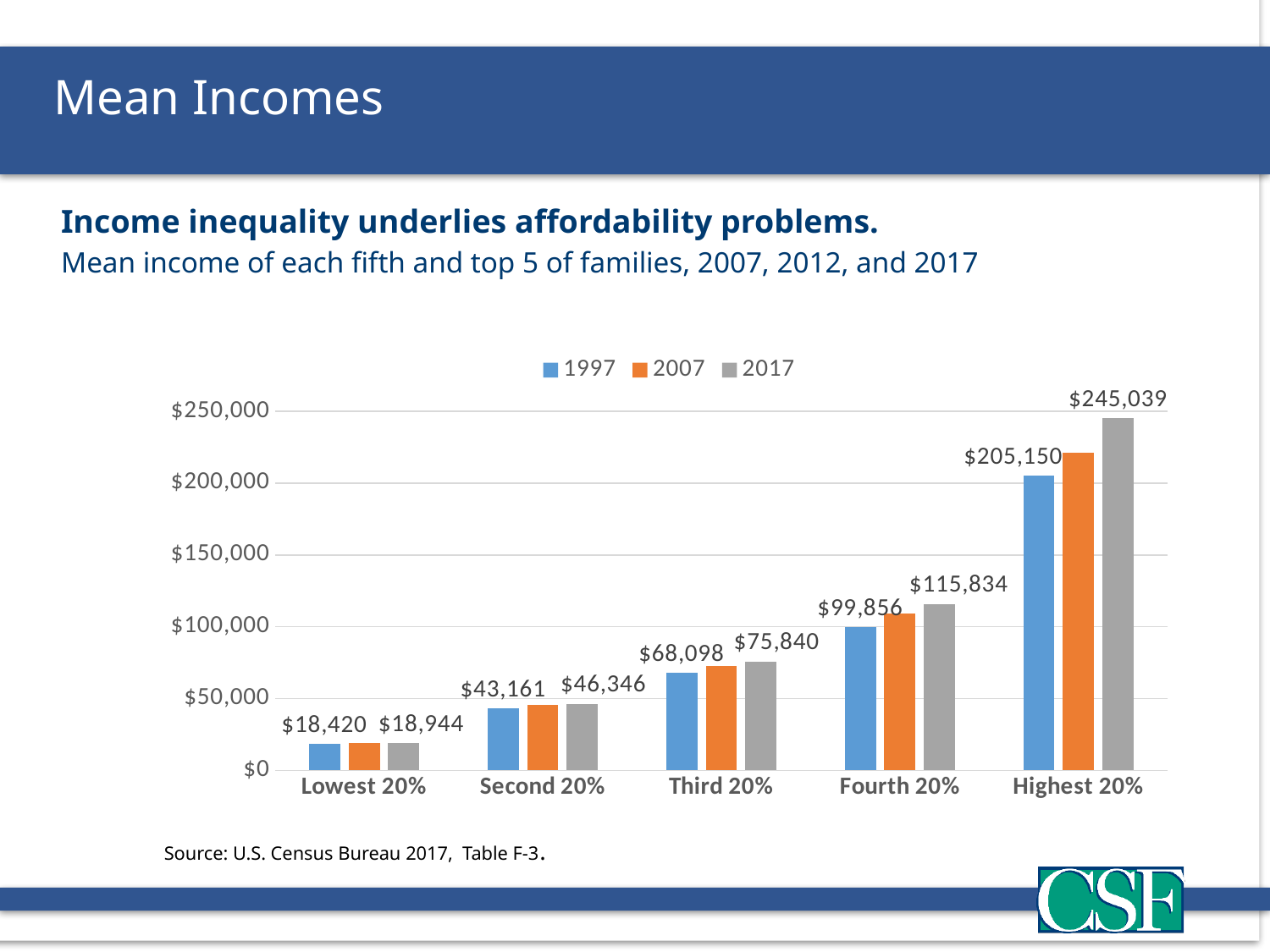
Which income group has the highest mean income in 2017? Highest 20% What is the mean income for the Second 20% in 1997? $43,161 What is the mean income for the Lowest 20% in 1997? $18,420 Which is larger: the 2017 mean income for the Fourth 20% or the 1997 mean income for the Highest 20%? 1997 mean income for the Highest 20% What kind of chart is shown on the slide? Bar chart Is the 2007 mean income for the Highest 20% greater or less than $200,000? greater How many series does the legend list? 3 What is the difference between the 2017 and 1997 mean incomes for the Third 20%? $7,742 What is the mean income for the Highest 20% in 2017? $245,039 How much higher is the 2017 mean income for the Highest 20% than the 1997 mean income for the same group? $39,889 What is the mean income for the Fourth 20% in 2017? $115,834 Which income group has the lowest mean income in 1997? Lowest 20%